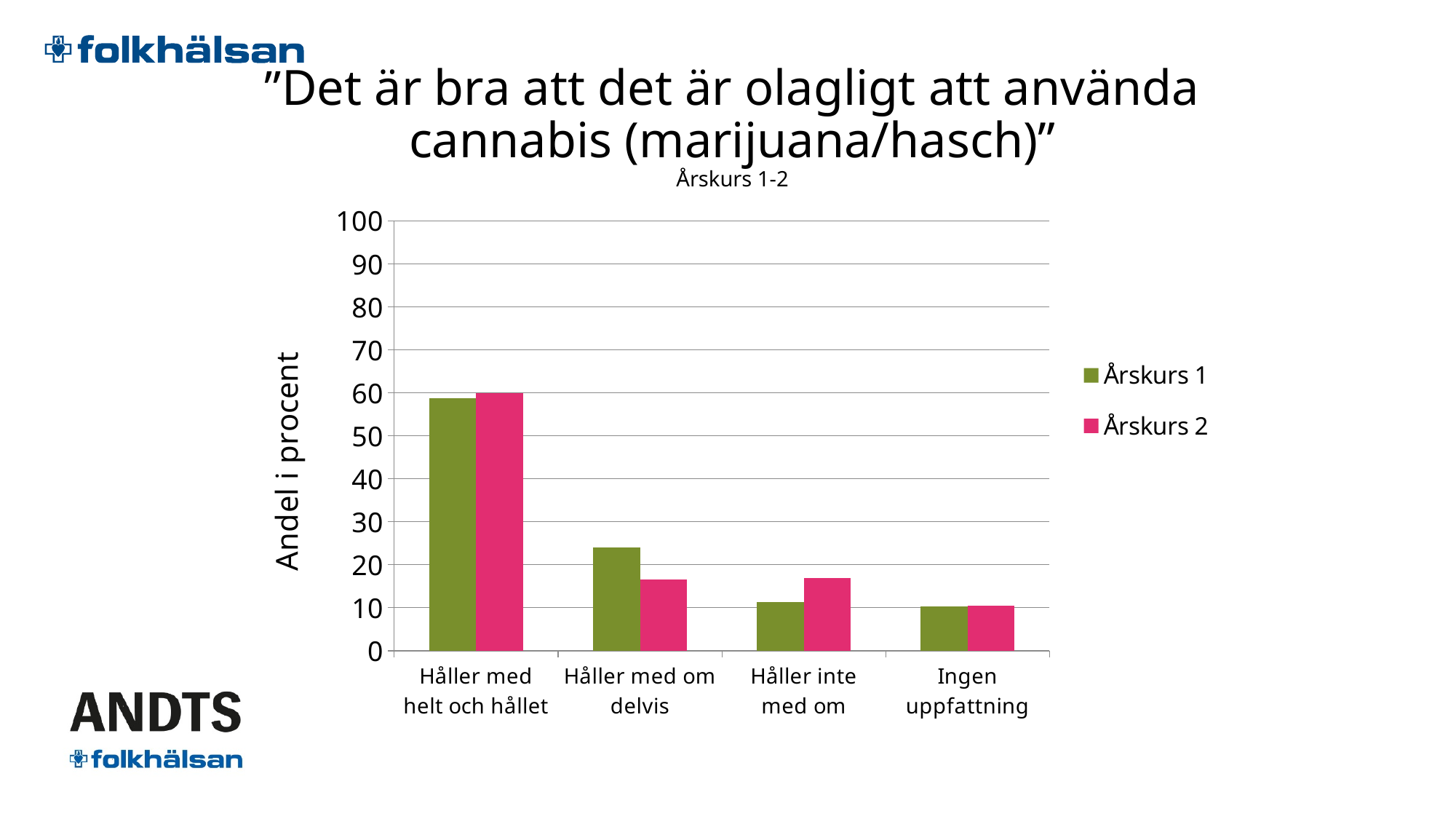
For 'Håller inte med om', which series has the larger value, Årskurs 1 or Årskurs 2? Årskurs 2 Which category has the highest value for Årskurs 1? Håller med helt och hållet Is the value for Årskurs 1 in 'Håller med helt och hållet' greater or less than 50? greater Which category has the highest value for Årskurs 2? Håller med helt och hållet What kind of chart is shown on the slide? bar chart Which category has the lowest value for Årskurs 2? Ingen uppfattning How many series does the legend list? 2 Is the value for Årskurs 2 in 'Håller med om delvis' greater or less than 20? less How many categories are shown on the x axis? 4 What is the label of the y axis? Andel i procent For 'Håller med om delvis', which series has the larger value, Årskurs 1 or Årskurs 2? Årskurs 1 What colour are the bars for Årskurs 2? pink